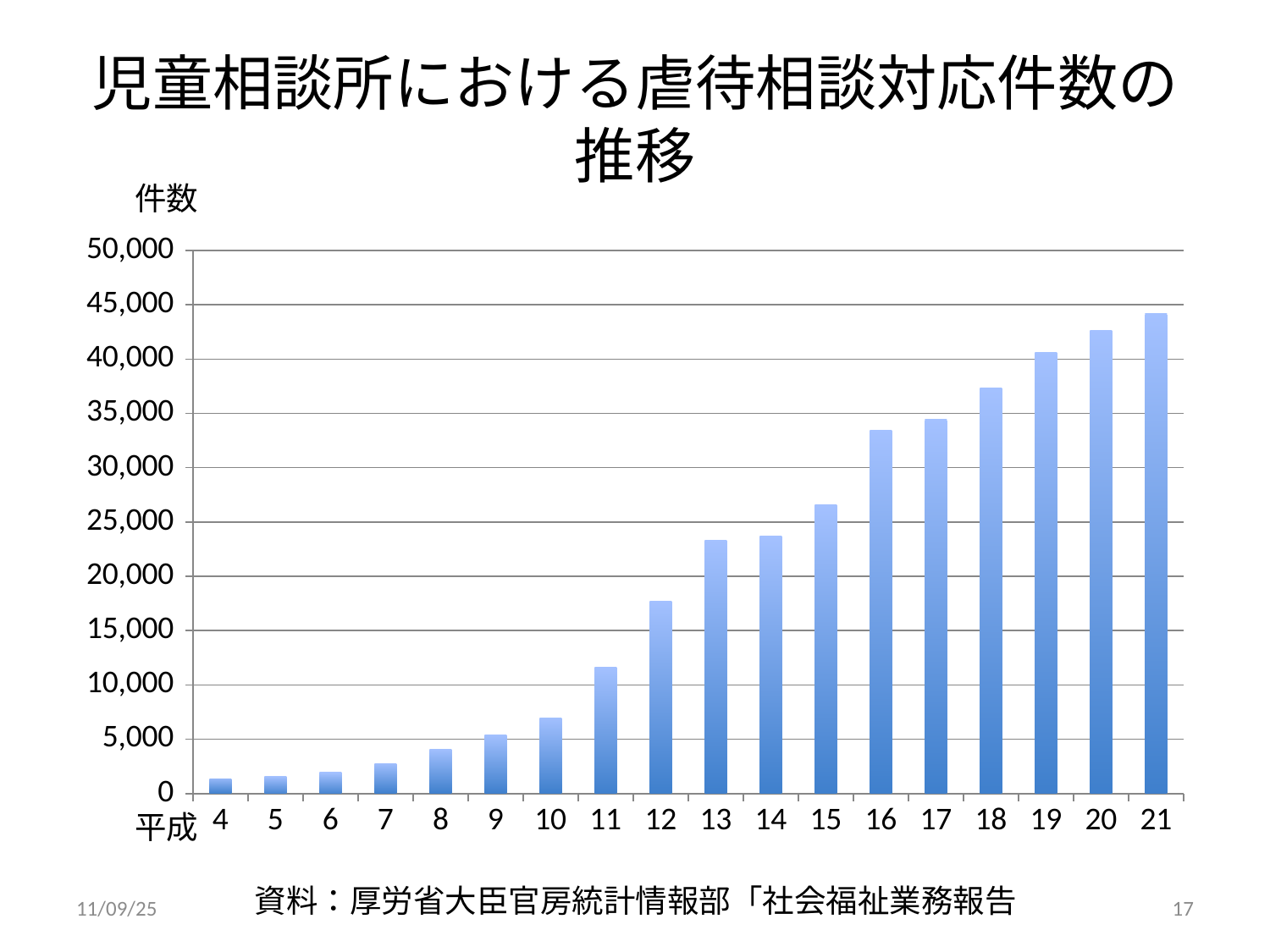
Is the value for 平成16 greater or less than 35,000? less How many years (categories) are plotted on the x axis? 18 Is the value for 平成12 greater or less than 15,000? greater Which year has the lowest number of cases? 平成4 What is the label on the vertical axis? 件数 Is the value for 平成21 greater or less than 40,000? greater Which is larger, the value for 平成18 or the value for 平成16? 平成18 What kind of chart is shown on the slide? bar chart Which year has the highest number of cases? 平成21 Do the values rise or fall from 平成4 to 平成21? rise What is the title of the chart? 児童相談所における虐待相談対応件数の推移